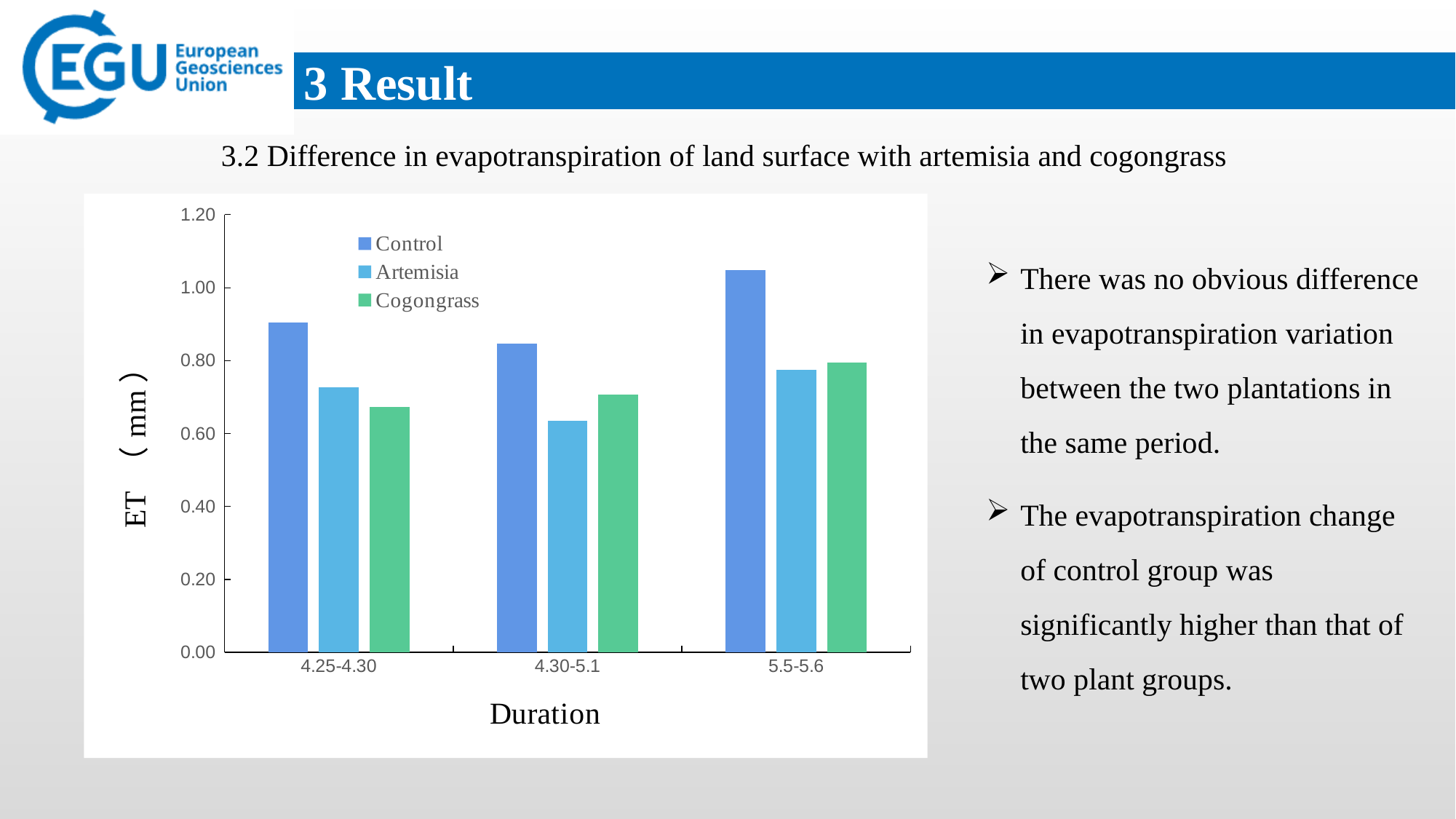
In which duration is the Control value highest? 5.5-5.6 Is the Control value for 5.5-5.6 greater or less than 1.00? greater How many series does the legend list? 3 Which is larger for 4.30-5.1, the Artemisia value or the Cogongrass value? Cogongrass Which is larger for 4.25-4.30, the Control value or the Artemisia value? Control How many duration categories are shown on the x axis? 3 Is the Artemisia value for 4.30-5.1 greater or less than 0.80? less In which duration is the Artemisia value lowest? 4.30-5.1 Is the Control value for 4.25-4.30 greater or less than 0.80? greater What is the label of the y axis? ET (mm) What kind of chart is shown on the slide? bar chart